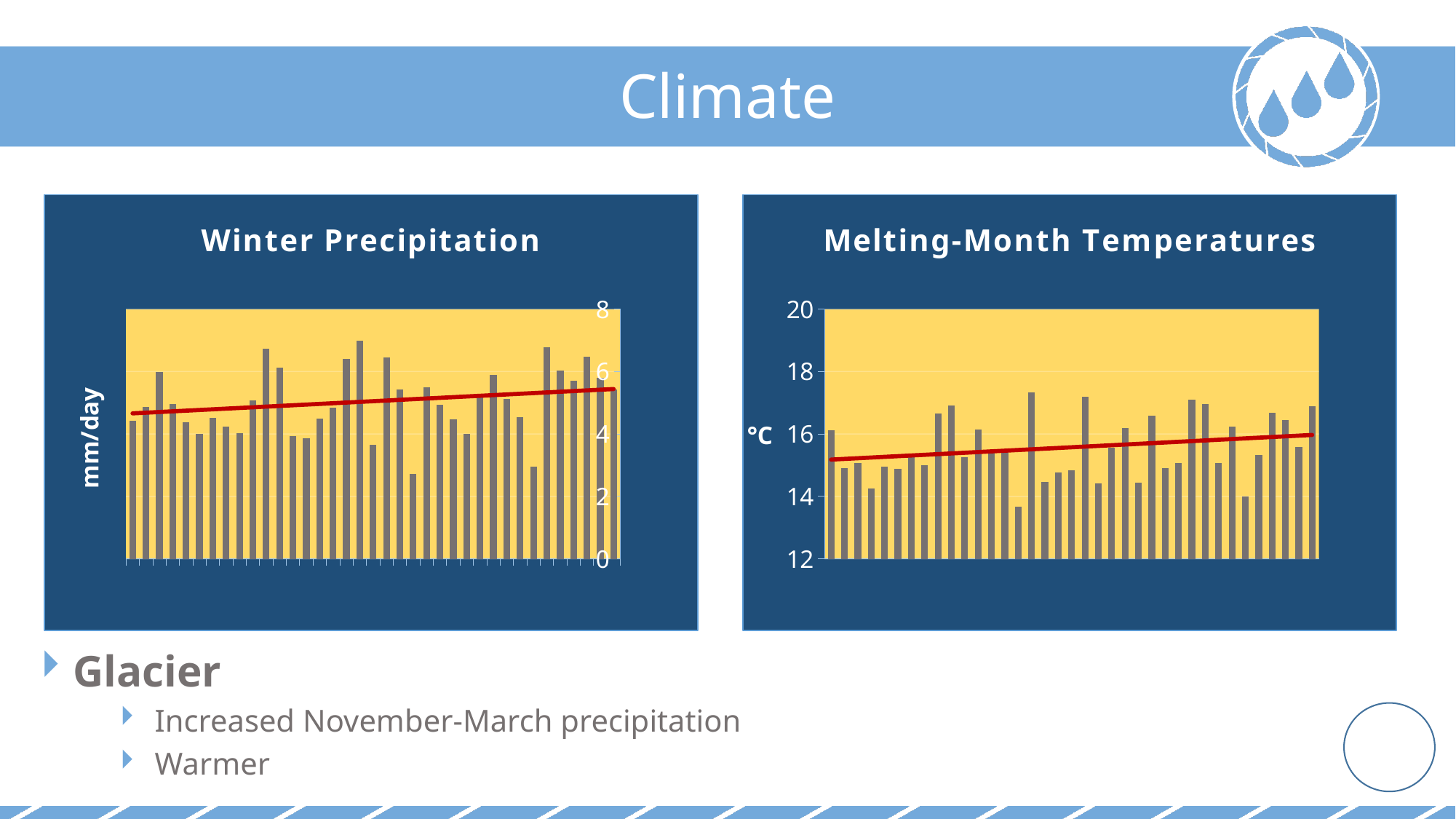
What unit is labelled on the y axis of the Winter Precipitation chart? mm/day What kind of chart is the Melting-Month Temperatures chart? bar chart In the Melting-Month Temperatures chart, does the red trend line rise or fall from left to right? rise In the Melting-Month Temperatures chart, is the tallest bar greater or less than 18 °C? less What is the highest value shown on the y axis of the Melting-Month Temperatures chart? 20 In the Melting-Month Temperatures chart, is the shortest bar greater or less than 14 °C? less In the Winter Precipitation chart, is the tallest bar greater or less than 6 mm/day? greater What kind of chart is the Winter Precipitation chart? bar chart In the Winter Precipitation chart, does the red trend line rise or fall from left to right? rise